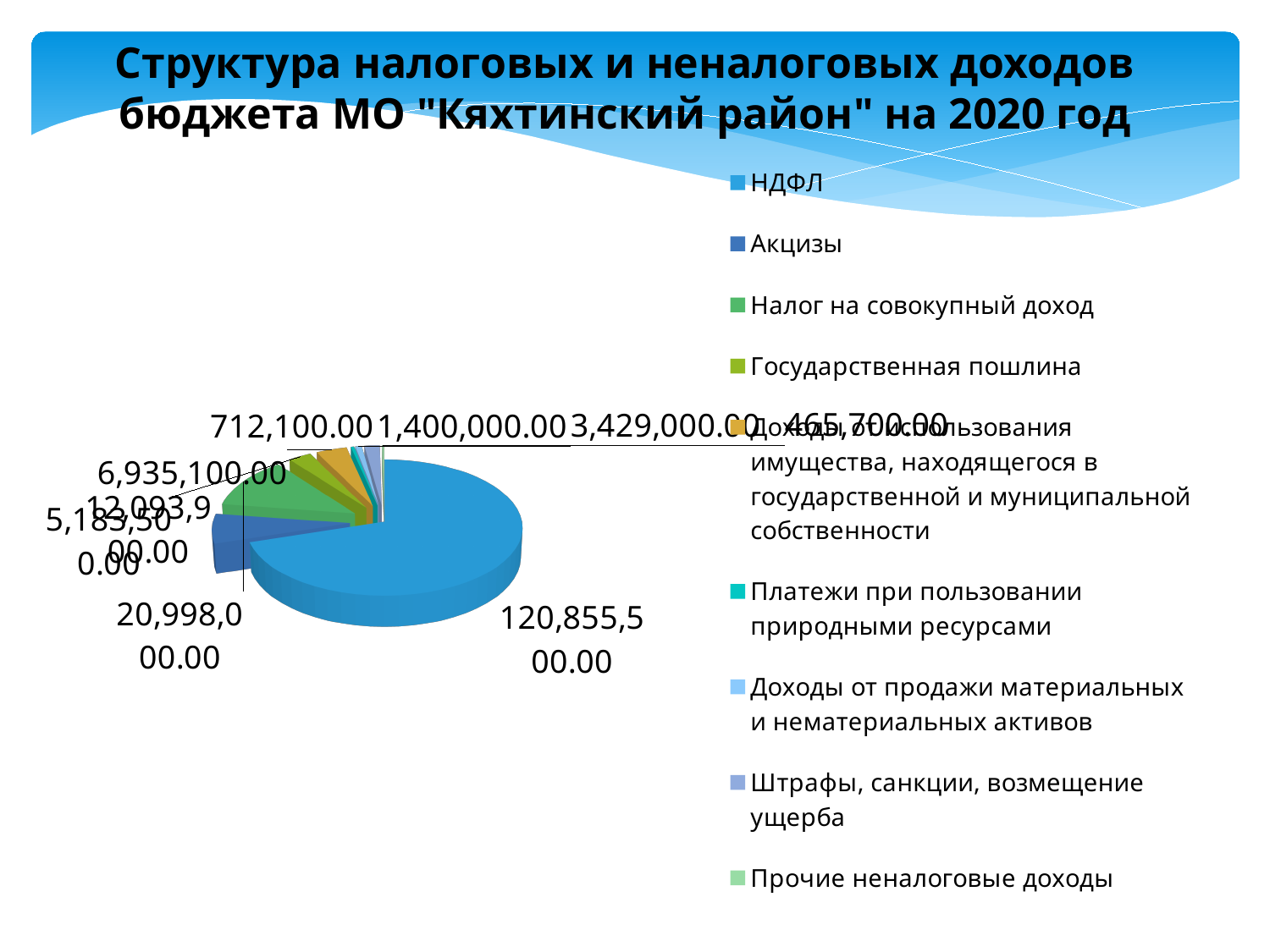
Which legend entry is listed last in the pie chart's legend? Прочие неналоговые доходы What kind of chart is shown on the slide? pie chart What is the smallest value printed as a data label on the pie chart? 465,700.00 What is the value shown for Акцизы in the pie chart? 12,093,900.00 How many categories does the legend of the pie chart list? 9 What is the title of the slide containing the pie chart? Структура налоговых и неналоговых доходов бюджета МО "Кяхтинский район" на 2020 год Which category has the largest slice of the pie chart? НДФЛ What is the value shown for the largest slice (НДФЛ) in the pie chart? 120,855,500.00 What is the difference between the НДФЛ value and the Акцизы value in the pie chart? 108,761,600.00 Which is larger in the pie chart, НДФЛ or Акцизы? НДФЛ